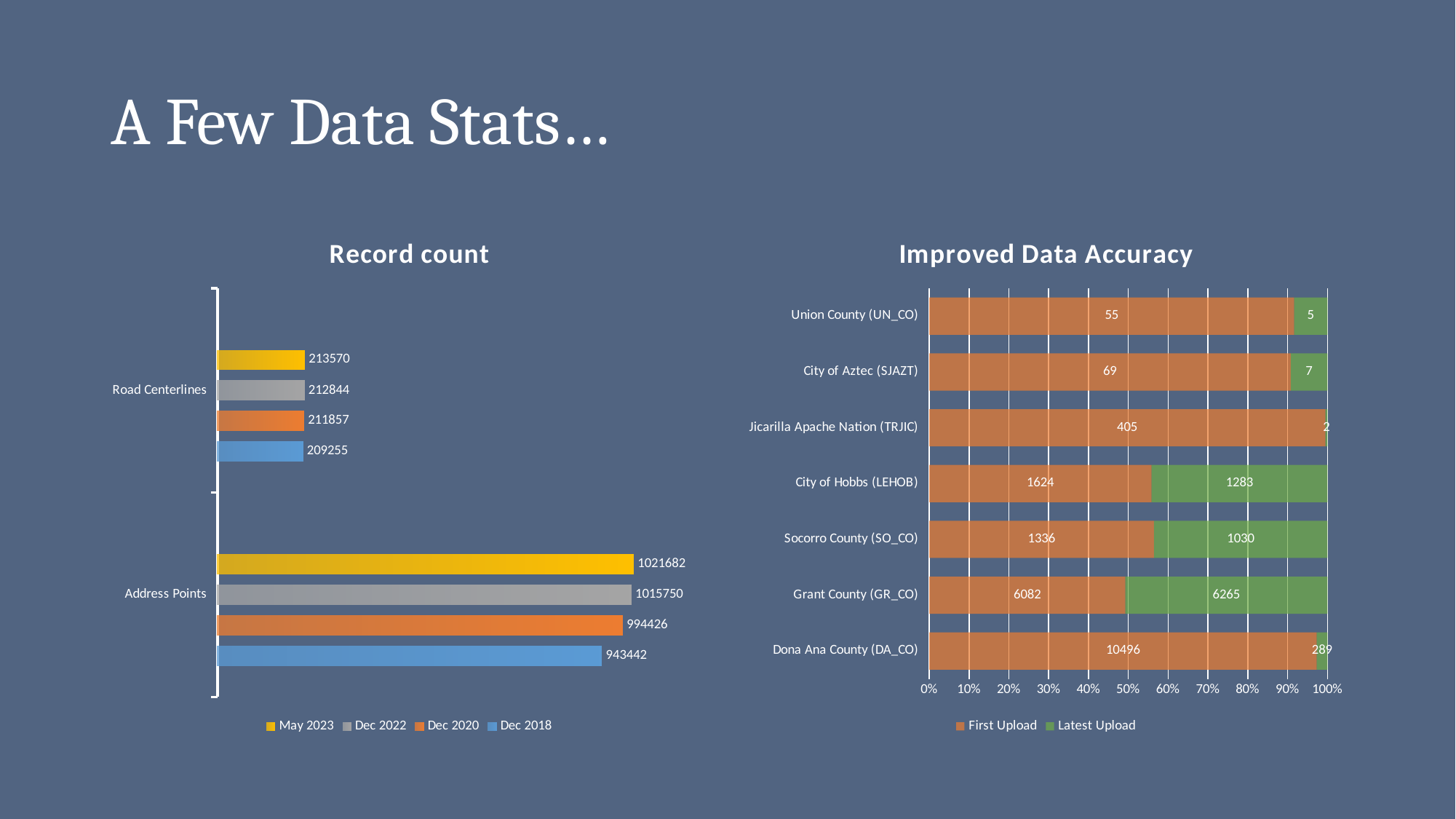
In the "Record count" chart, what is the May 2023 value for Address Points? 1021682 In the "Record count" chart, what is the difference between the May 2023 and Dec 2018 values for Address Points? 78240 In the "Record count" chart, what is the Dec 2018 value for Road Centerlines? 209255 In the "Improved Data Accuracy" chart, what are the two legend entries? First Upload and Latest Upload What kind of chart is the "Record count" chart? Bar chart In the "Improved Data Accuracy" chart, what is the total of First Upload and Latest Upload for Socorro County (SO_CO)? 2366 In the "Record count" chart, which series has the lowest value for Road Centerlines? Dec 2018 In the "Improved Data Accuracy" chart, how many categories are shown? 7 In the "Improved Data Accuracy" chart, what is the First Upload value for Dona Ana County (DA_CO)? 10496 In the "Improved Data Accuracy" chart, what is the Latest Upload value for City of Hobbs (LEHOB)? 1283 In the "Record count" chart, how many series does the legend list? 4 In the "Improved Data Accuracy" chart, which is larger for Grant County (GR_CO): First Upload or Latest Upload? Latest Upload